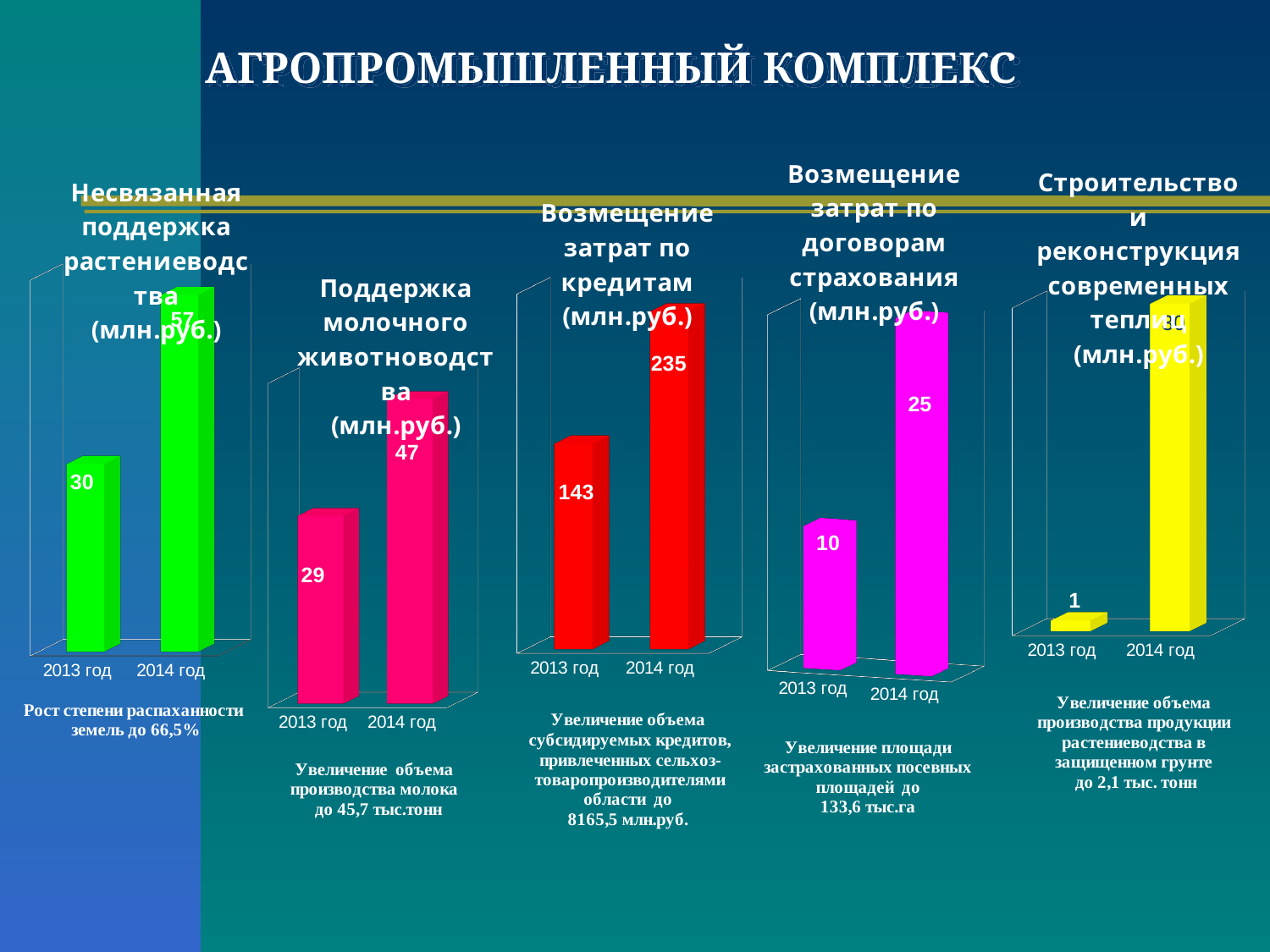
In the chart titled "Поддержка молочного животноводства (млн.руб.)", which year has the higher value? 2014 год In the chart titled "Возмещение затрат по договорам страхования (млн.руб.)", what is the value for 2014 год? 25 In the chart titled "Возмещение затрат по кредитам (млн.руб.)", what is the value for 2013 год? 143 In the chart titled "Поддержка молочного животноводства (млн.руб.)", what is the value for 2013 год? 29 In the chart titled "Возмещение затрат по кредитам (млн.руб.)", what is the value for 2014 год? 235 In the chart titled "Возмещение затрат по договорам страхования (млн.руб.)", what is the value for 2013 год? 10 In the chart titled "Несвязанная поддержка растениеводства (млн.руб.)", what is the value for 2013 год? 30 In the chart titled "Возмещение затрат по кредитам (млн.руб.)", what is the difference between the 2014 год and 2013 год values? 92 In the chart titled "Возмещение затрат по кредитам (млн.руб.)", do the values rise or fall from 2013 год to 2014 год? rise In the chart titled "Поддержка молочного животноводства (млн.руб.)", what is the value for 2014 год? 47 What kind of chart is the one titled "Возмещение затрат по договорам страхования (млн.руб.)"? bar chart In the chart titled "Строительство и реконструкция современных теплиц (млн.руб.)", what is the value for 2013 год? 1